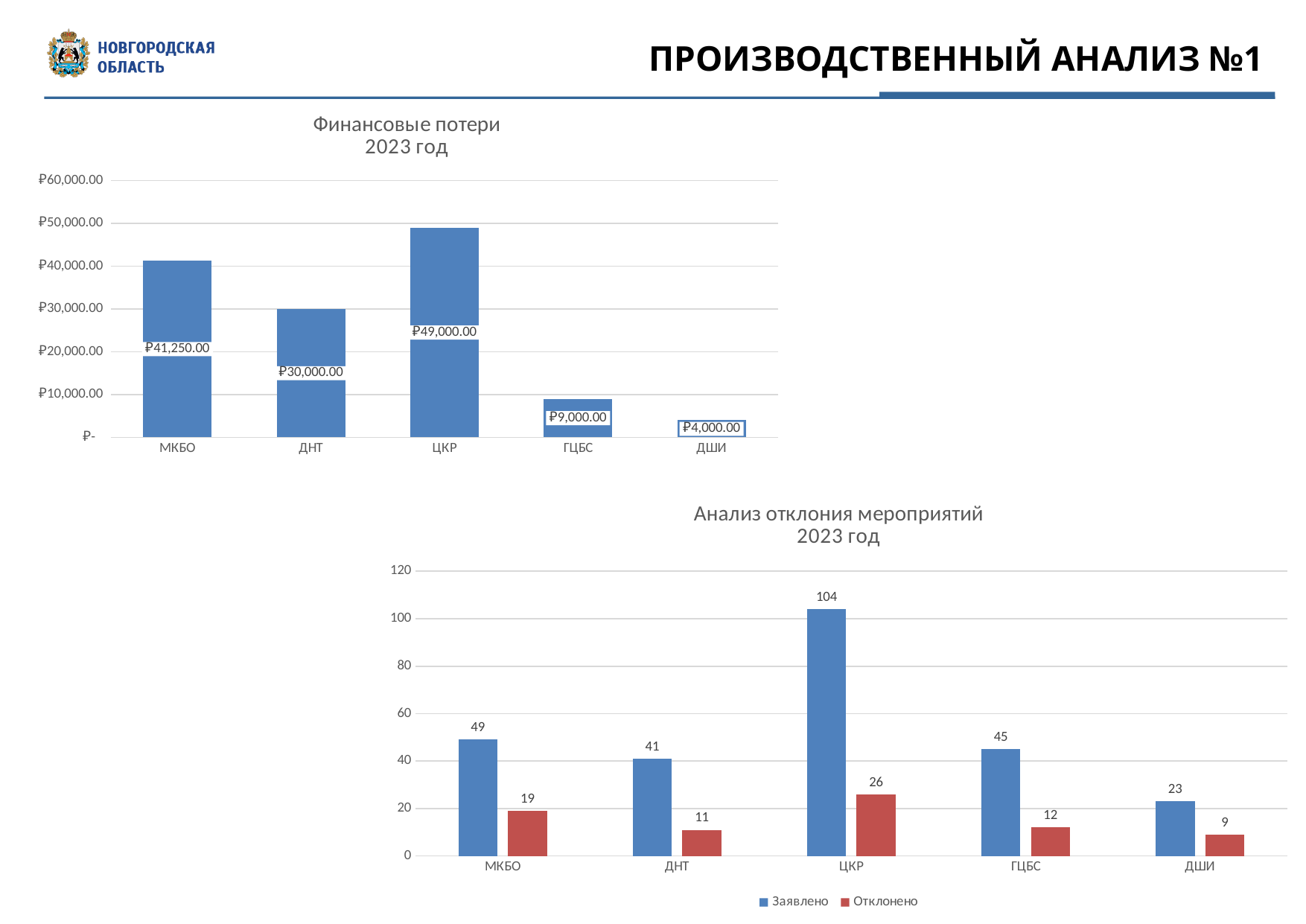
In the 'Анализ отклония мероприятий 2023 год' chart, what is the difference between the Заявлено and Отклонено values for ГЦБС? 33 What kind of chart is the 'Анализ отклония мероприятий 2023 год' chart? bar chart In the 'Анализ отклония мероприятий 2023 год' chart, what is the Заявлено value for ЦКР? 104 In the 'Финансовые потери 2023 год' chart, what is the value for ЦКР? ₽49,000.00 In the 'Финансовые потери 2023 год' chart, how many categories are shown on the x axis? 5 In the 'Финансовые потери 2023 год' chart, what is the difference between the values for МКБО and ДНТ? ₽11,250.00 In the 'Анализ отклония мероприятий 2023 год' chart, how many series does the legend list? 2 In the 'Финансовые потери 2023 год' chart, which category has the highest value? ЦКР In the 'Финансовые потери 2023 год' chart, which category has the lowest value? ДШИ In the 'Финансовые потери 2023 год' chart, is the value for ГЦБС greater or less than ₽10,000.00? less In the 'Анализ отклония мероприятий 2023 год' chart, which category has the lowest Заявлено value? ДШИ In the 'Анализ отклония мероприятий 2023 год' chart, what is the Отклонено value for ДНТ? 11